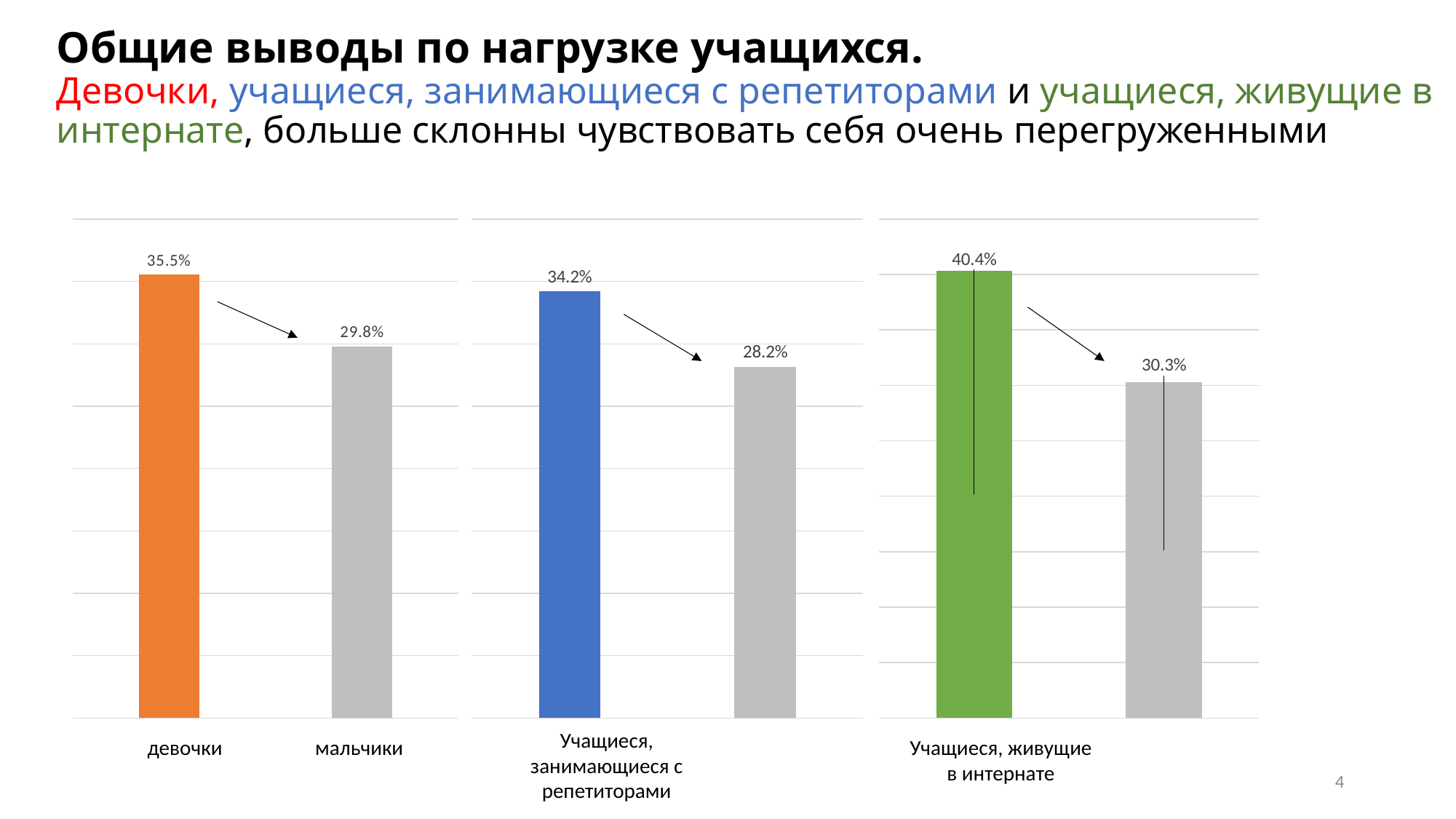
In the left chart, which category has the higher value, девочки or мальчики? девочки In the middle chart, what is the value for Учащиеся, занимающиеся с репетиторами? 34.2% In the middle chart, what is the value shown on the grey bar on the right? 28.2% In the right chart, what is the value shown on the grey bar? 30.3% In the left chart, what is the difference between the values for девочки and мальчики? 5.7% How many bars does the left chart have? 2 In the right chart, what is the difference between the green bar and the grey bar? 10.1% In the left chart, what is the value for девочки? 35.5% In the left chart, what is the value for мальчики? 29.8% What kind of chart is the left chart? bar chart In the right chart, what is the value for Учащиеся, живущие в интернате? 40.4% In the middle chart, what is the difference between the blue bar and the grey bar? 6.0%